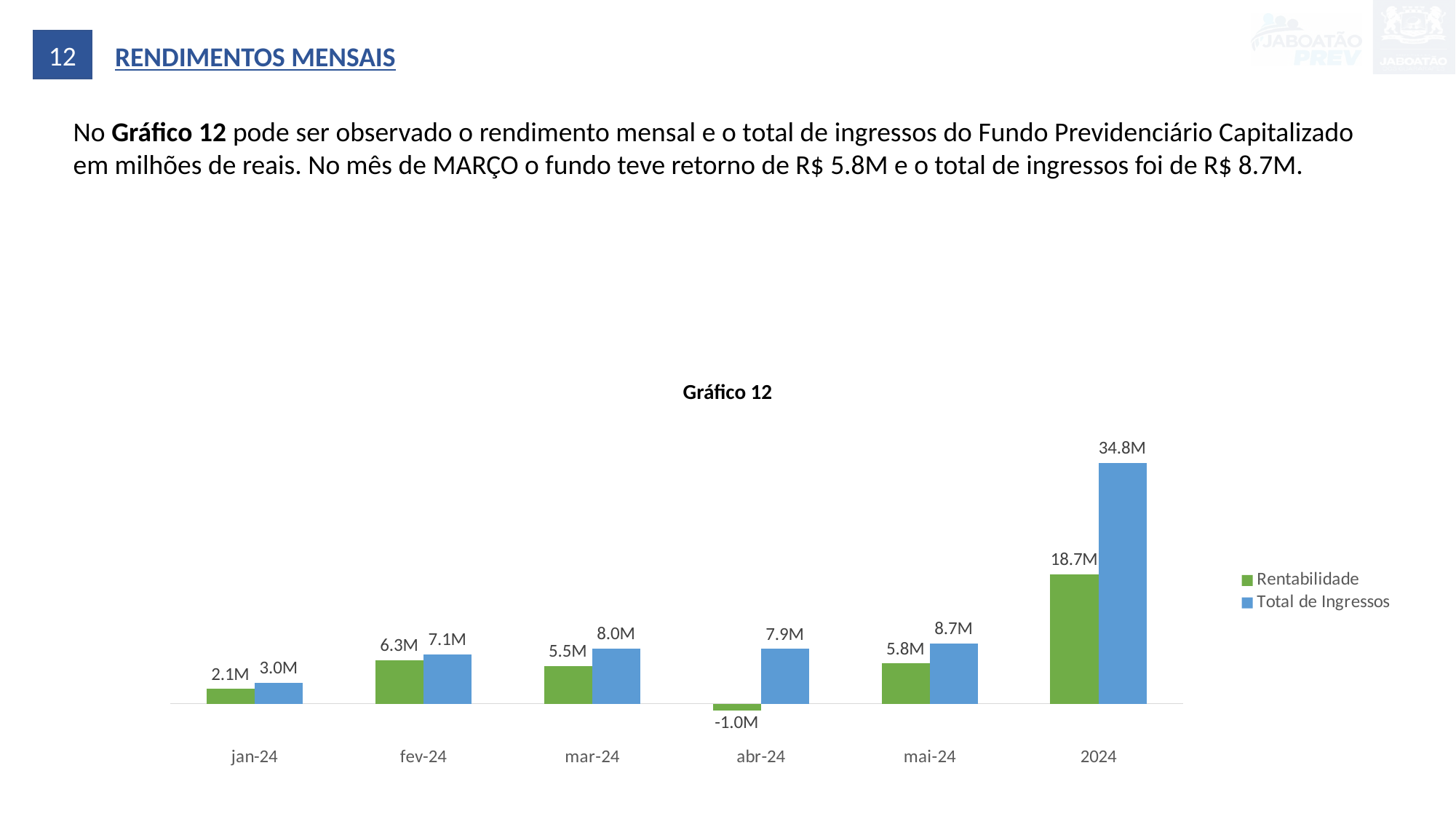
What is the Total de Ingressos value for abr-24? 7.9M What is the Rentabilidade value for abr-24? -1.0M How many series does the legend list? 2 Which is larger for jan-24: Rentabilidade or Total de Ingressos? Total de Ingressos What is the Total de Ingressos value for 2024? 34.8M How many categories are shown on the x axis? 6 What is the Rentabilidade value for mar-24? 5.5M What kind of chart is Gráfico 12? Bar chart What is the difference between Total de Ingressos and Rentabilidade for fev-24? 0.8M Which category has the lowest Rentabilidade value? abr-24 What colour represents the Total de Ingressos series? Blue Among the monthly categories (excluding 2024), which has the highest Total de Ingressos value? mai-24